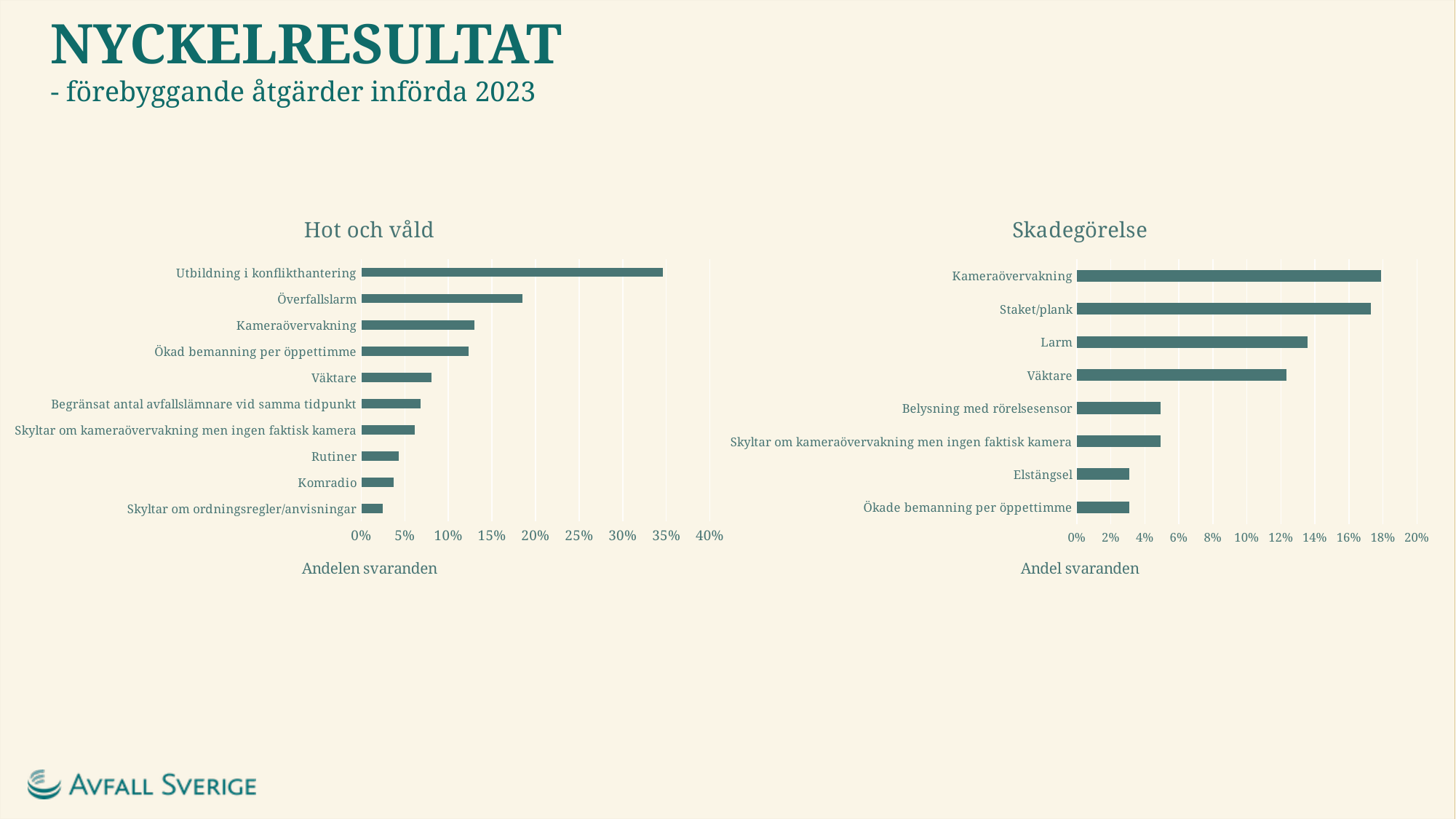
How many categories are shown in the 'Hot och våld' chart? 10 In the 'Hot och våld' chart, which category has the highest value? Utbildning i konflikthantering In the 'Skadegörelse' chart, is the value for Larm greater or less than 12%? greater In the 'Hot och våld' chart, which category has the lowest value? Skyltar om ordningsregler/anvisningar In the 'Hot och våld' chart, is the value for Utbildning i konflikthantering greater or less than 30%? greater How many categories are shown in the 'Skadegörelse' chart? 8 In the 'Hot och våld' chart, is the value for Överfallslarm greater or less than 20%? less In the 'Skadegörelse' chart, which is larger: Kameraövervakning or Larm? Kameraövervakning What kind of chart is the 'Skadegörelse' chart? Bar chart In the 'Hot och våld' chart, which is larger: Överfallslarm or Kameraövervakning? Överfallslarm